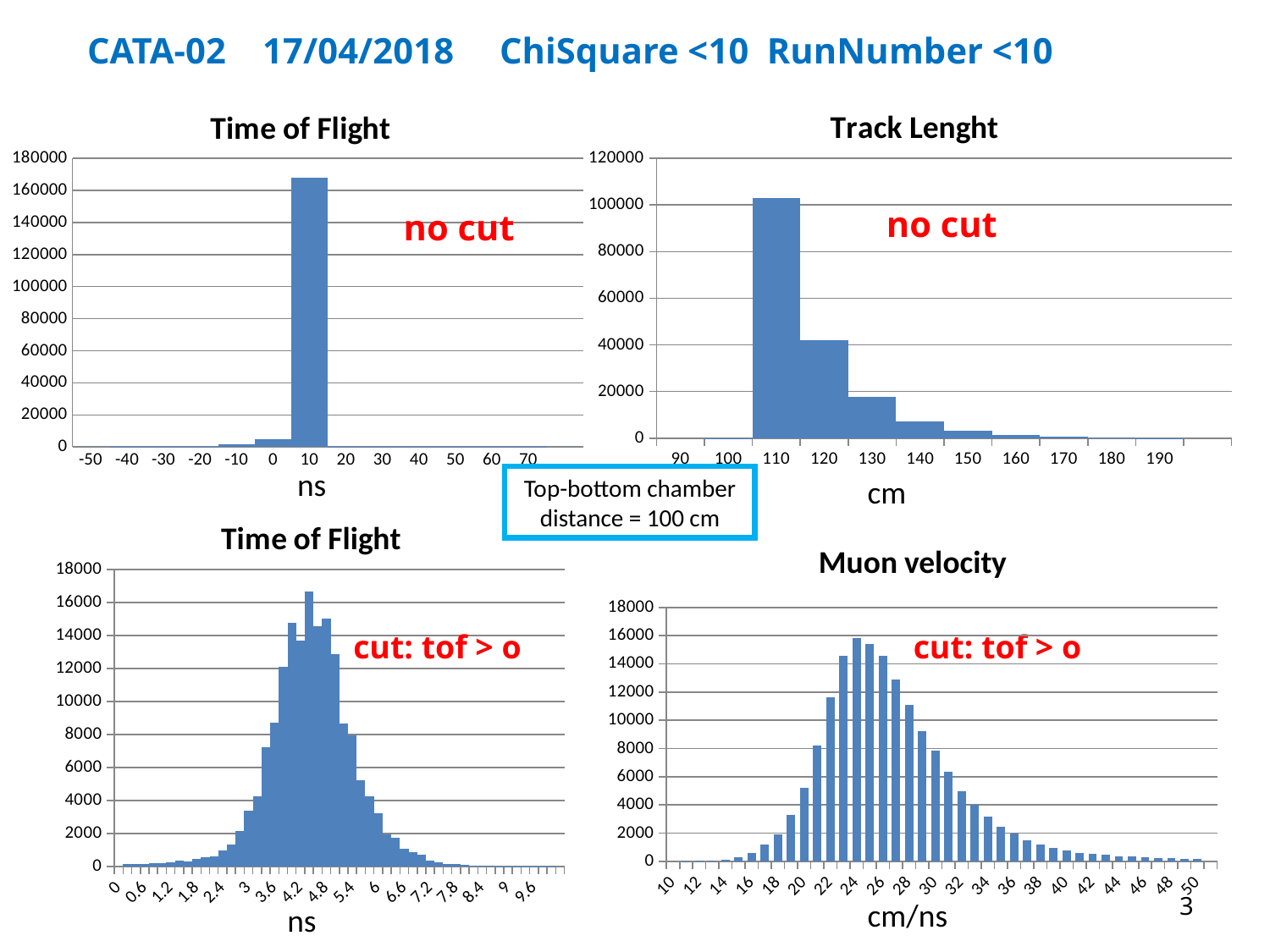
In the Track Lenght chart, which bin has the larger count, 110 cm or 120 cm? 110 cm In the Track Lenght chart, which cm bin has the highest count? 110 What kind of chart is the Muon velocity chart? bar chart In the Muon velocity chart, which bin has the larger count, 24 cm/ns or 36 cm/ns? 24 cm/ns In the Track Lenght chart, is the value for the 110 cm bin greater or less than 80000? greater What unit is shown on the x axis of the Muon velocity chart? cm/ns In the Muon velocity chart, is the value of the tallest bar greater or less than 14000? greater In the top-left Time of Flight chart, which ns bin has the highest count? 10 In the top-left Time of Flight chart, is the value of the tallest bar greater or less than 160000? greater In the Track Lenght chart, do the counts rise or fall as track length increases from 110 cm to 190 cm? fall